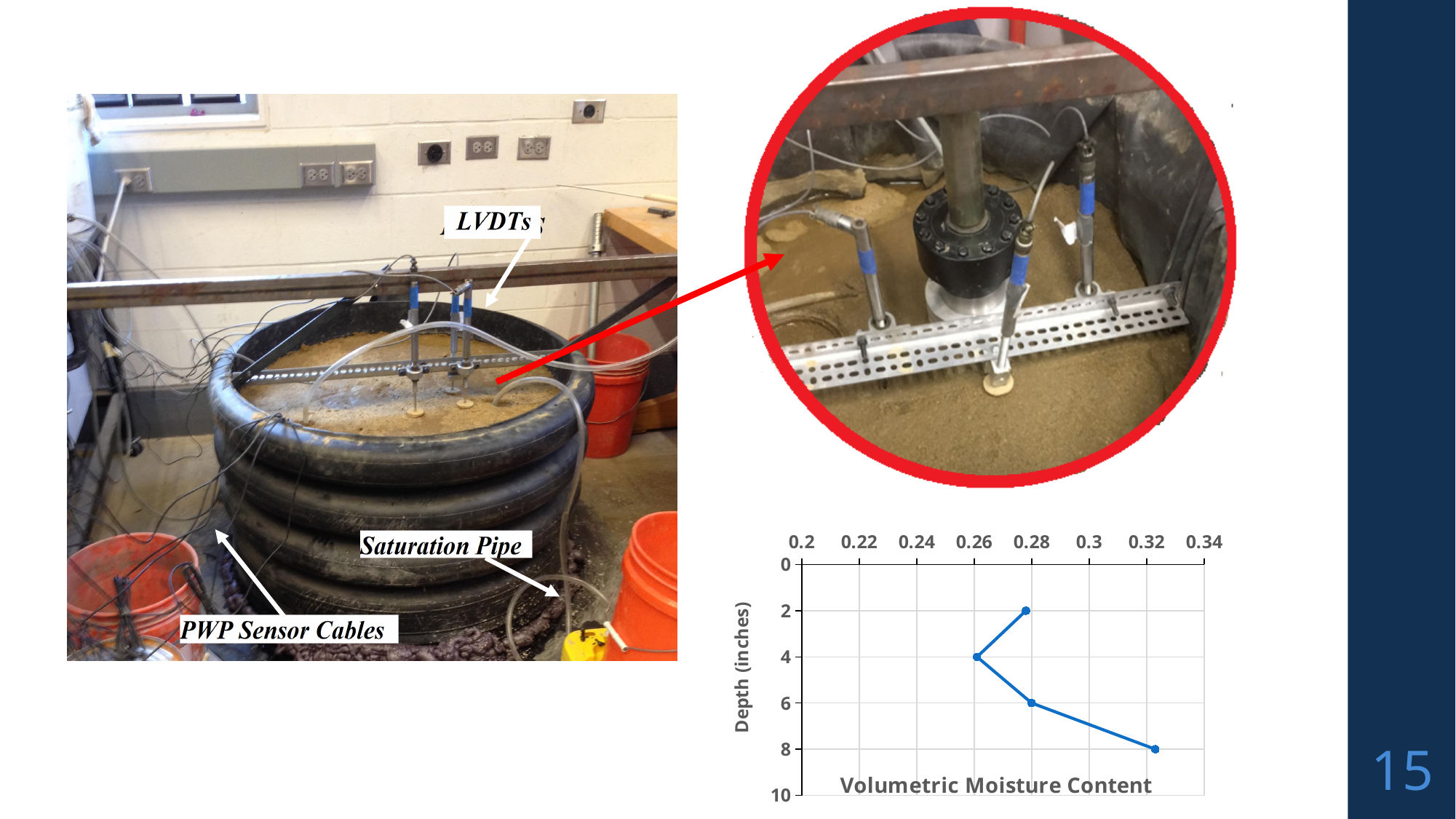
What is the label of the horizontal axis of the chart? Volumetric Moisture Content Does the volumetric moisture content increase or decrease as depth goes from 4 inches to 8 inches? increase At which depth is the volumetric moisture content lowest? 4 inches Which depth has a higher volumetric moisture content, 6 inches or 4 inches? 6 inches How many data points are plotted on the chart? 4 Is the volumetric moisture content at a depth of 4 inches greater or less than 0.28? less Is the volumetric moisture content at a depth of 2 inches greater or less than 0.26? greater What kind of chart is shown on the slide? line chart At which depth is the volumetric moisture content highest? 8 inches Is the volumetric moisture content at a depth of 8 inches greater or less than 0.3? greater What is the label of the vertical axis of the chart? Depth (inches) Which depth has a higher volumetric moisture content, 8 inches or 2 inches? 8 inches